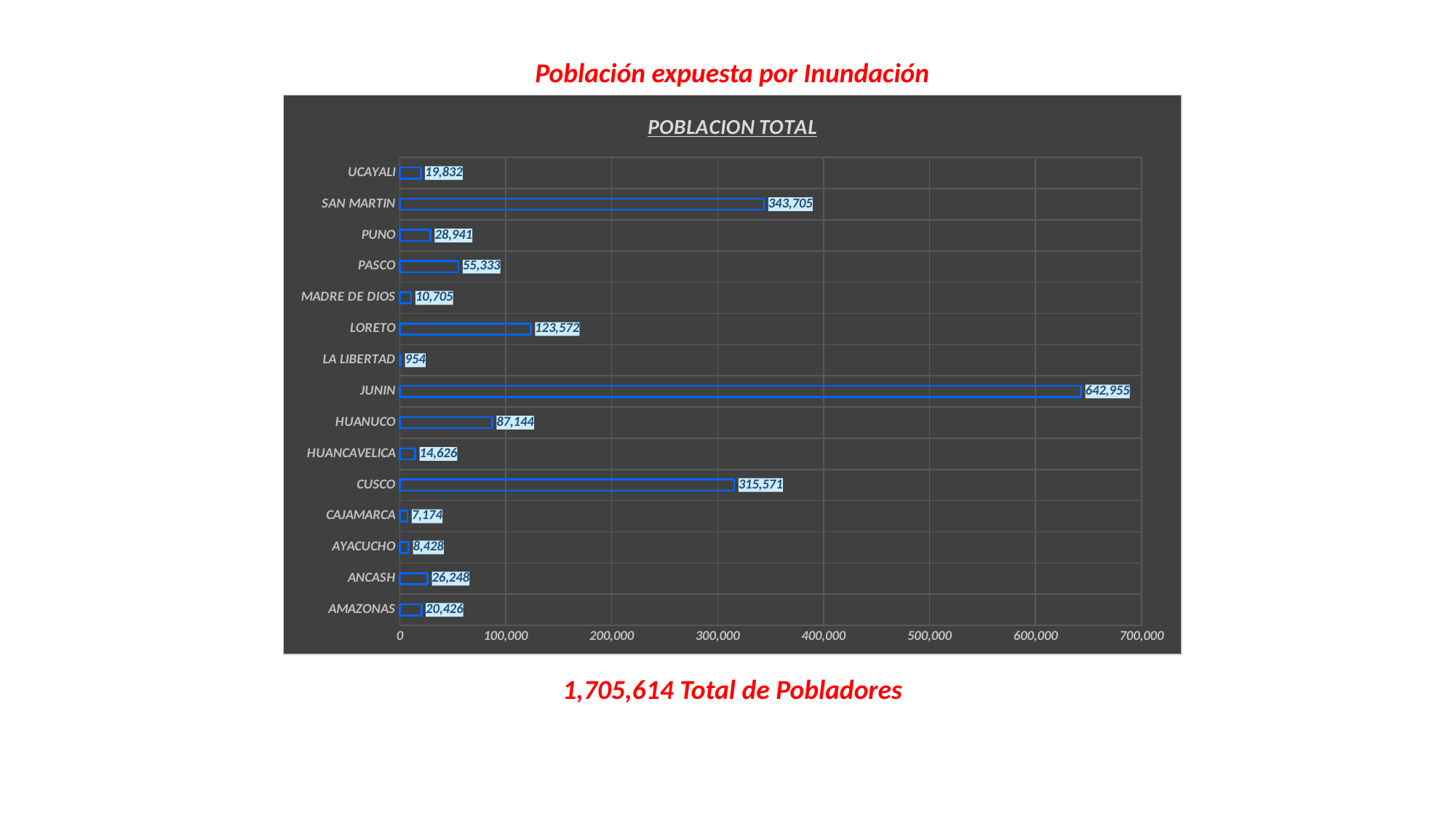
Is the value for CUSCO greater or less than 300,000? greater Which category has the highest value? JUNIN How many categories are shown in the chart? 15 Which category has the lowest value? LA LIBERTAD What is the value for LORETO? 123,572 What is the value for MADRE DE DIOS? 10,705 Which is larger, the value for PASCO or the value for HUANUCO? HUANUCO What is the difference between the values for SAN MARTIN and CUSCO? 28,134 What kind of chart is shown on the slide? bar chart What is the value for JUNIN? 642,955 What is the difference between the values for ANCASH and AMAZONAS? 5,822 What is the title of the chart? POBLACION TOTAL